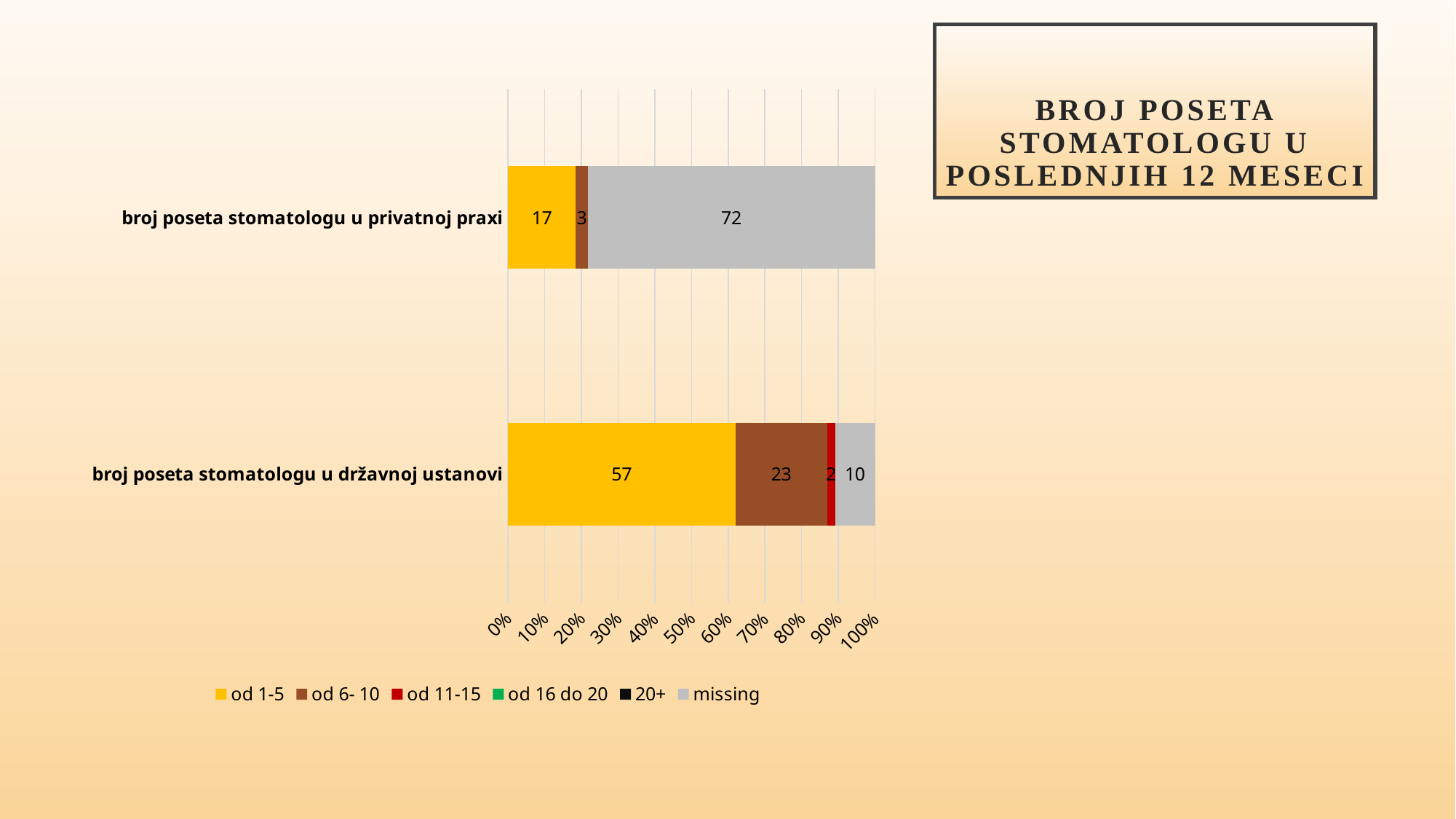
What is the value of the 'missing' segment for 'broj poseta stomatologu u privatnoj praxi'? 72 What is the value of the 'od 1-5' segment for 'broj poseta stomatologu u državnoj ustanovi'? 57 Which category has the larger 'missing' value, 'broj poseta stomatologu u privatnoj praxi' or 'broj poseta stomatologu u državnoj ustanovi'? broj poseta stomatologu u privatnoj praxi What is the value of the 'od 11-15' segment for 'broj poseta stomatologu u državnoj ustanovi'? 2 How many categories are shown on the chart? 2 What is the value of the 'od 1-5' segment for 'broj poseta stomatologu u privatnoj praxi'? 17 What kind of chart is shown on the slide? Stacked bar chart How many series does the legend list? 6 What is the value of the 'od 6- 10' segment for 'broj poseta stomatologu u državnoj ustanovi'? 23 What is the value of the 'missing' segment for 'broj poseta stomatologu u državnoj ustanovi'? 10 What is the difference between the 'od 1-5' values for 'broj poseta stomatologu u državnoj ustanovi' and 'broj poseta stomatologu u privatnoj praxi'? 40 What is the title shown on the slide? BROJ POSETA STOMATOLOGU U POSLEDNJIH 12 MESECI